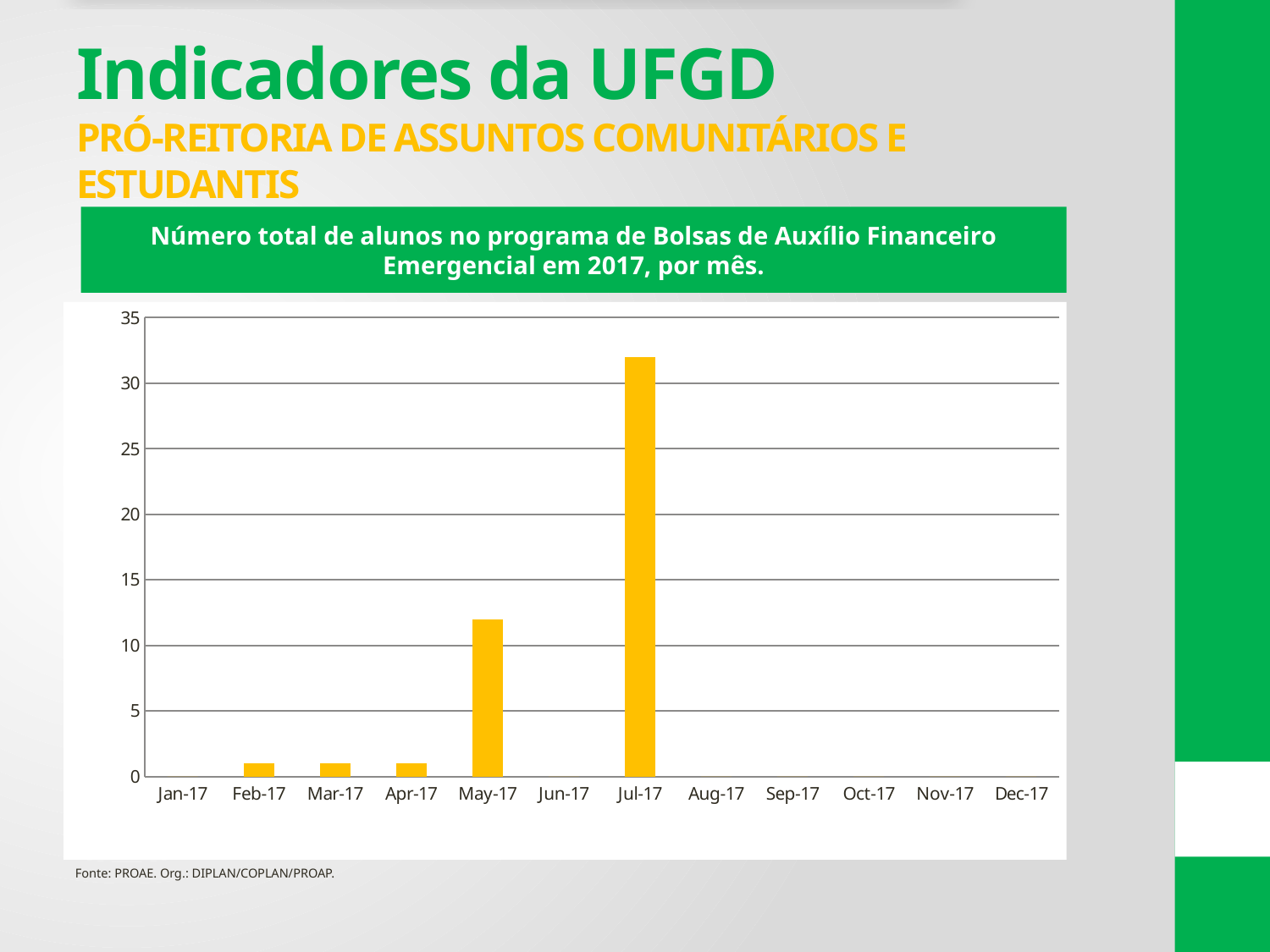
Is the value for May-17 greater or less than 15? less What is the title of the chart? Número total de alunos no programa de Bolsas de Auxílio Financeiro Emergencial em 2017, por mês. Is the value for May-17 greater or less than 10? greater Which month has the highest number of students in the chart? Jul-17 What kind of chart is shown on the slide? bar chart Is the value for Feb-17 greater or less than 5? less Which month has the larger value, Apr-17 or May-17? May-17 Which month has the larger value, May-17 or Jul-17? Jul-17 How many months are shown on the x axis of the chart? 12 How many months show a visible bar in the chart? 5 What is the highest value shown on the y axis of the chart? 35